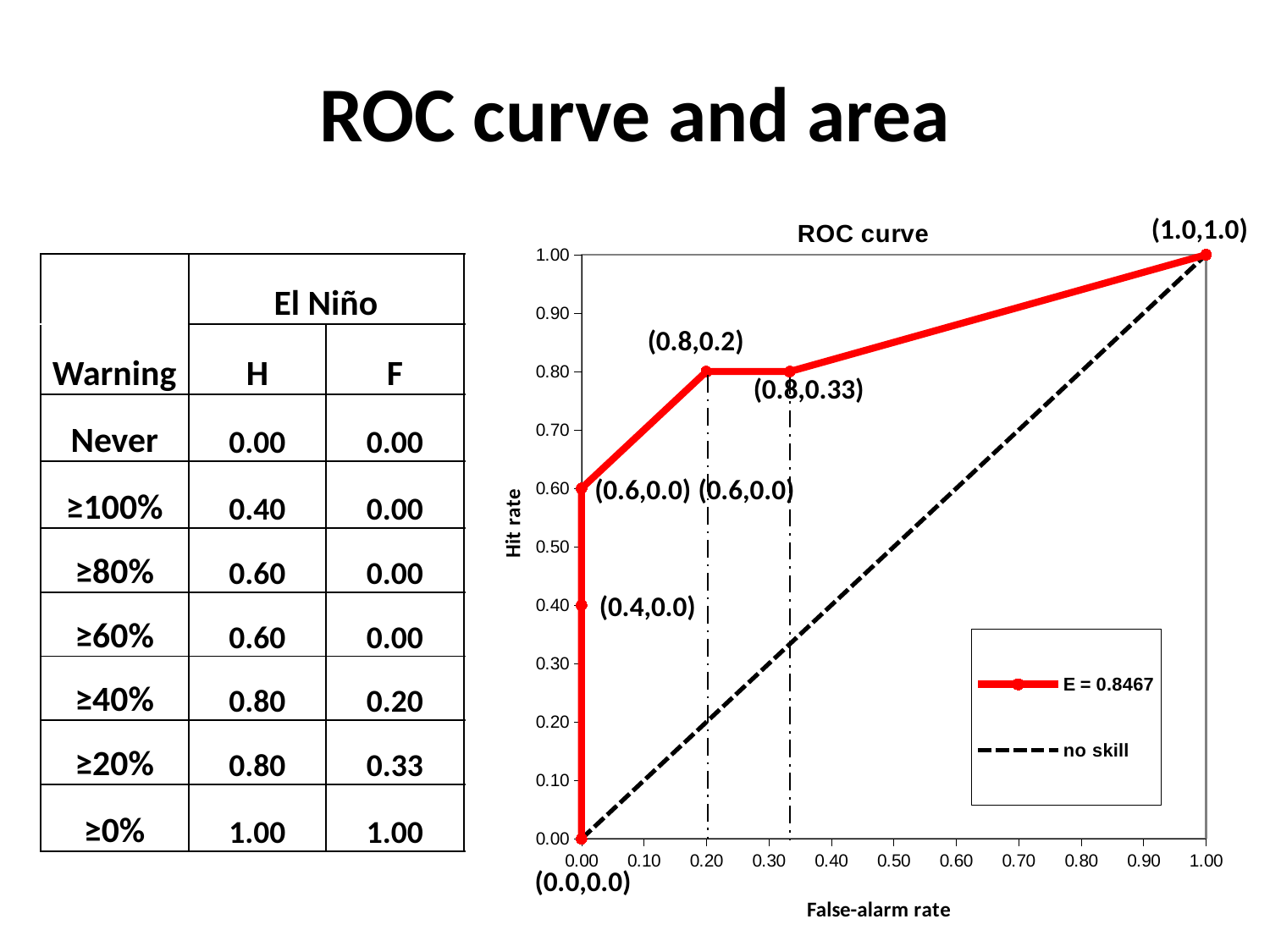
In the ROC curve chart, what is the hit rate at a false-alarm rate of 0.20? 0.80 What is the highest hit rate reached by the ROC curve? 1.00 What value of E is given in the legend of the ROC curve chart? 0.8467 In the ROC curve chart, what is the hit rate at a false-alarm rate of 0.33? 0.80 Is the hit rate of the ROC curve at a false-alarm rate of 0.20 greater or less than 0.50? greater What are the two entries in the legend of the ROC curve chart? E = 0.8467 and no skill What kind of chart is shown on the slide? Line chart How many series does the legend of the ROC curve chart list? 2 Does the hit rate of the ROC curve rise or fall as the false-alarm rate increases? Rises In the ROC curve chart, what is the difference between the hit rate at a false-alarm rate of 1.00 and the hit rate at a false-alarm rate of 0.33? 0.20 In the ROC curve chart, which is larger: the hit rate at a false-alarm rate of 0.33 or at a false-alarm rate of 1.00? At 1.00 In the ROC curve chart, what is the hit rate at a false-alarm rate of 1.00? 1.00